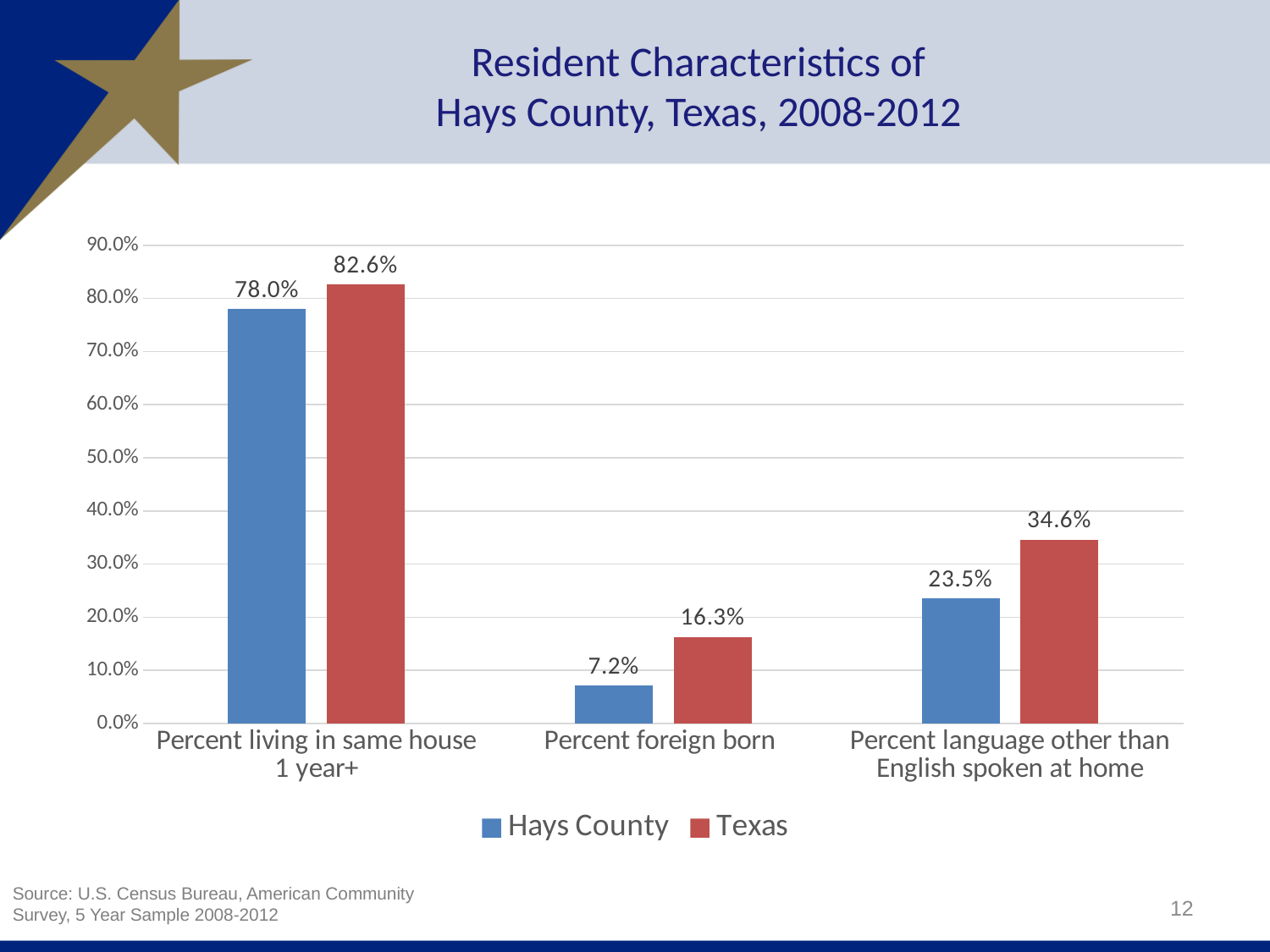
What is the value for Texas for Percent foreign born? 16.3% Which is larger for Percent living in same house 1 year+: Hays County or Texas? Texas What is the value for Hays County for Percent living in same house 1 year+? 78.0% What kind of chart is shown on the slide? Bar chart Which category has the lowest value for Hays County? Percent foreign born How many categories are shown on the x axis? 3 Which category has the highest value for Texas? Percent living in same house 1 year+ What is the value for Hays County for Percent language other than English spoken at home? 23.5% What is the difference between the Texas and Hays County values for Percent language other than English spoken at home? 11.1% What is the value for Texas for Percent language other than English spoken at home? 34.6% How many series does the legend list? 2 What is the difference between the Texas and Hays County values for Percent foreign born? 9.1%